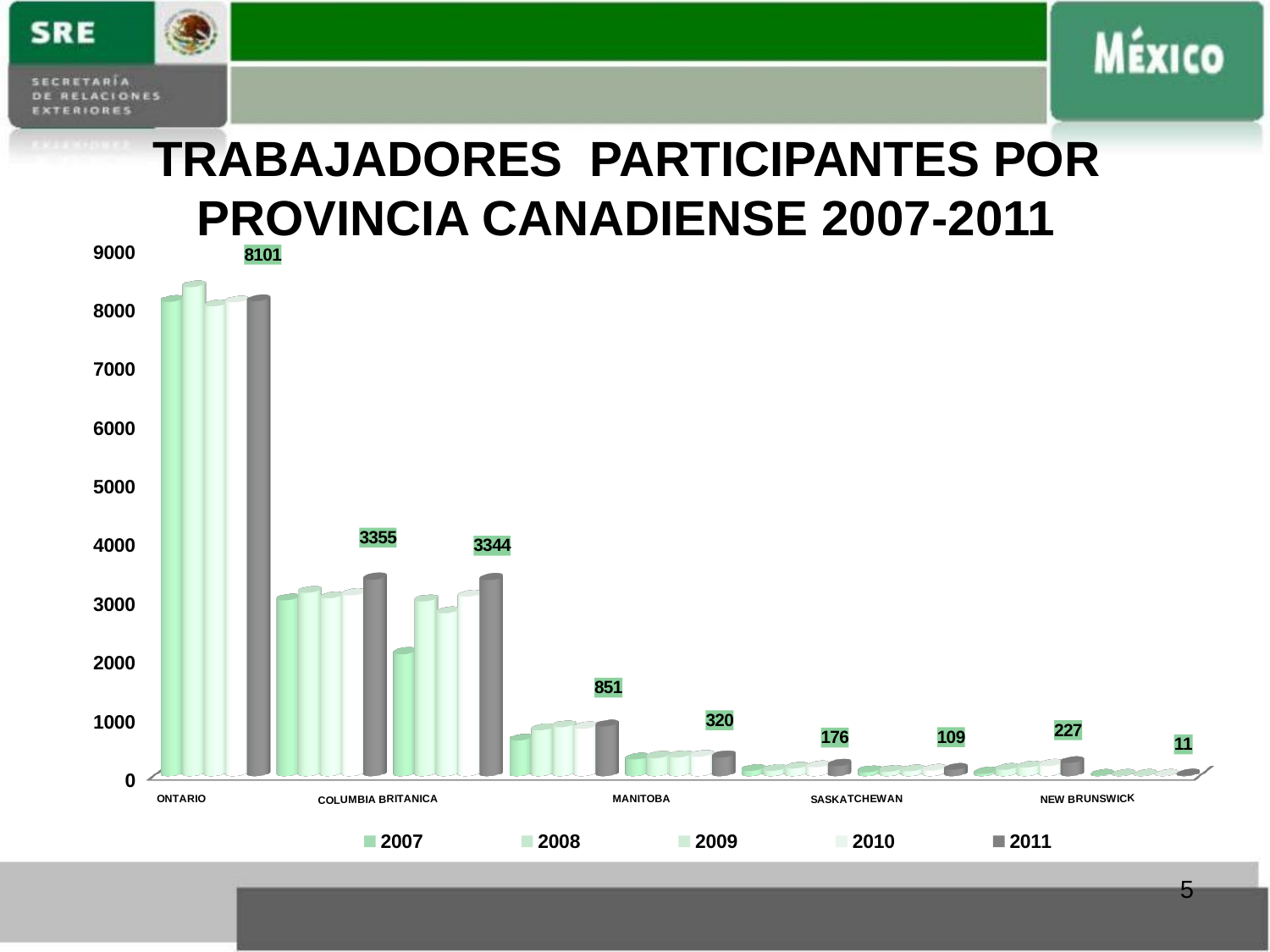
What is the difference between the 2011 values for ONTARIO and COLUMBIA BRITANICA? 4757 Is the 2008 value for ONTARIO greater or less than 8000? greater What is the 2011 value for COLUMBIA BRITANICA? 3344 What is the 2011 value for SASKATCHEWAN? 109 Which province has the highest 2011 value? ONTARIO What is the 2011 value for NEW BRUNSWICK? 11 How many series does the legend list? 5 Which is larger in 2011, NEW BRUNSWICK or SASKATCHEWAN? SASKATCHEWAN What is the 2011 value for ONTARIO? 8101 What is the 2011 value for MANITOBA? 320 What is the difference between the 2011 values for MANITOBA and SASKATCHEWAN? 211 What kind of chart is shown on the slide? bar chart